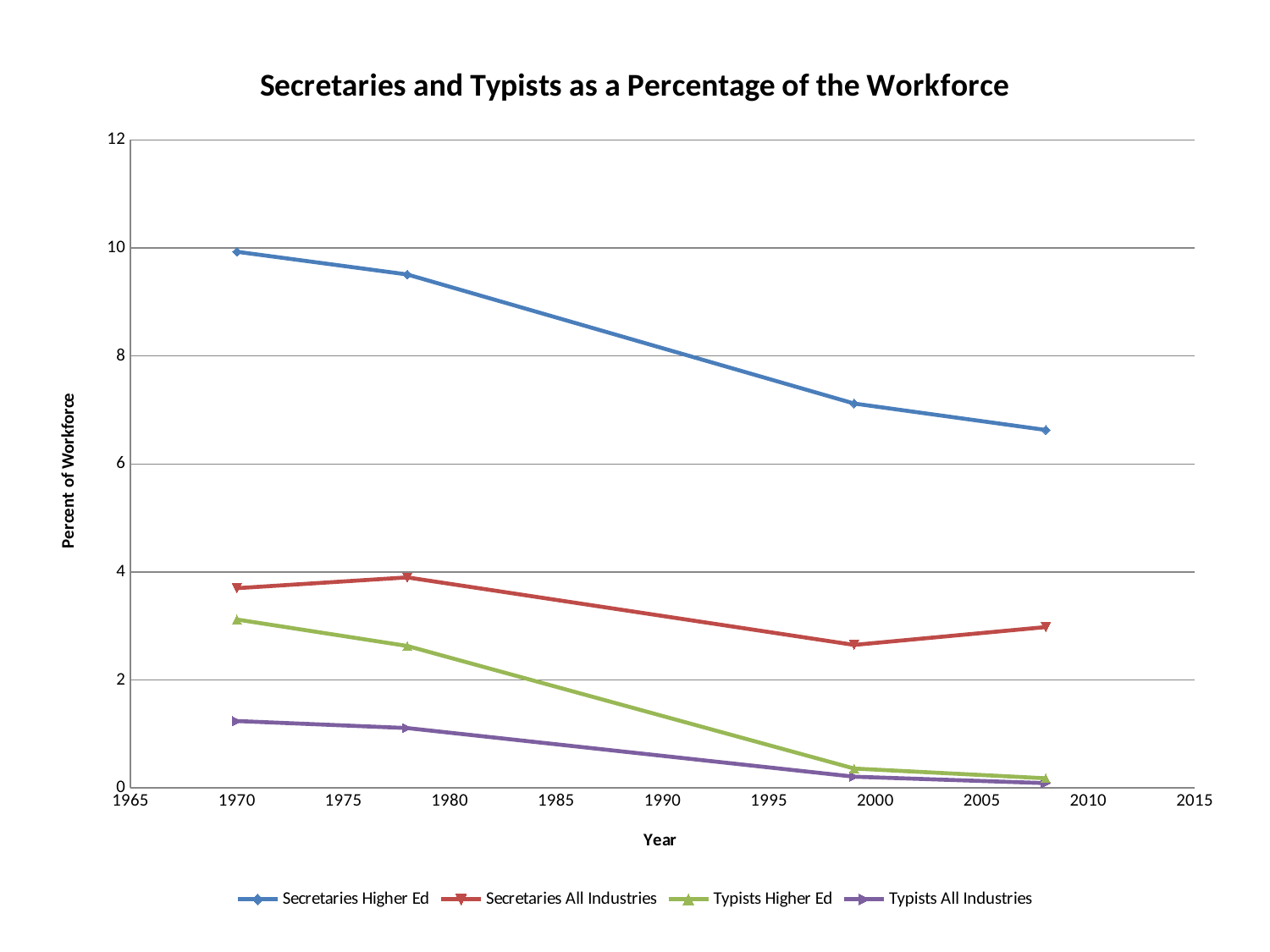
Does the Secretaries Higher Ed series rise or fall from 1970 to its last point? fall Is the value for Secretaries Higher Ed in 1970 greater or less than 8? greater In 1970, which is larger: Secretaries Higher Ed or Secretaries All Industries? Secretaries Higher Ed Which series has the highest value in 1970? Secretaries Higher Ed Is the value for Typists Higher Ed in 1970 greater or less than 4? less Which series has the lowest value in 1970? Typists All Industries What kind of chart is shown on the slide? line chart Is the value for Typists All Industries in 1970 greater or less than 2? less How many series does the legend list? 4 What is the title of the chart? Secretaries and Typists as a Percentage of the Workforce What is the label on the vertical axis? Percent of Workforce